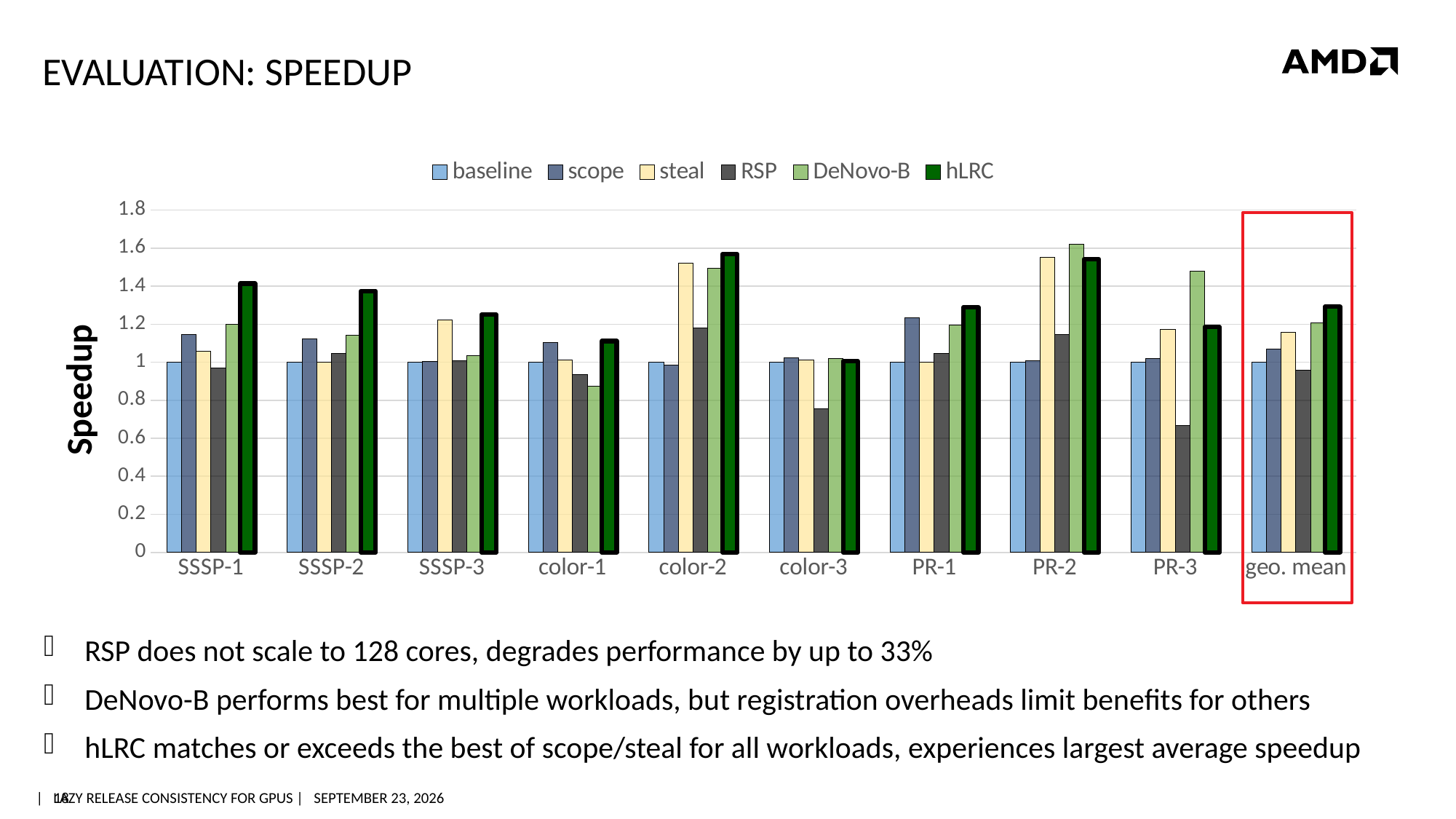
What is the speedup value for baseline in SSSP-1? 1 Is the value for RSP in PR-3 greater or less than 0.8? less Is the value for DeNovo-B in color-1 greater or less than 1? less Is the value for DeNovo-B in PR-2 greater or less than 1.4? greater How many series does the legend list? 6 How many workload categories are shown on the x axis? 10 Which series has the lowest speedup for color-3? RSP Which series has the highest speedup for PR-3? DeNovo-B What is the label on the y axis? Speedup What kind of chart is shown on the slide? bar chart For geo. mean, which is larger: the hLRC value or the scope value? hLRC